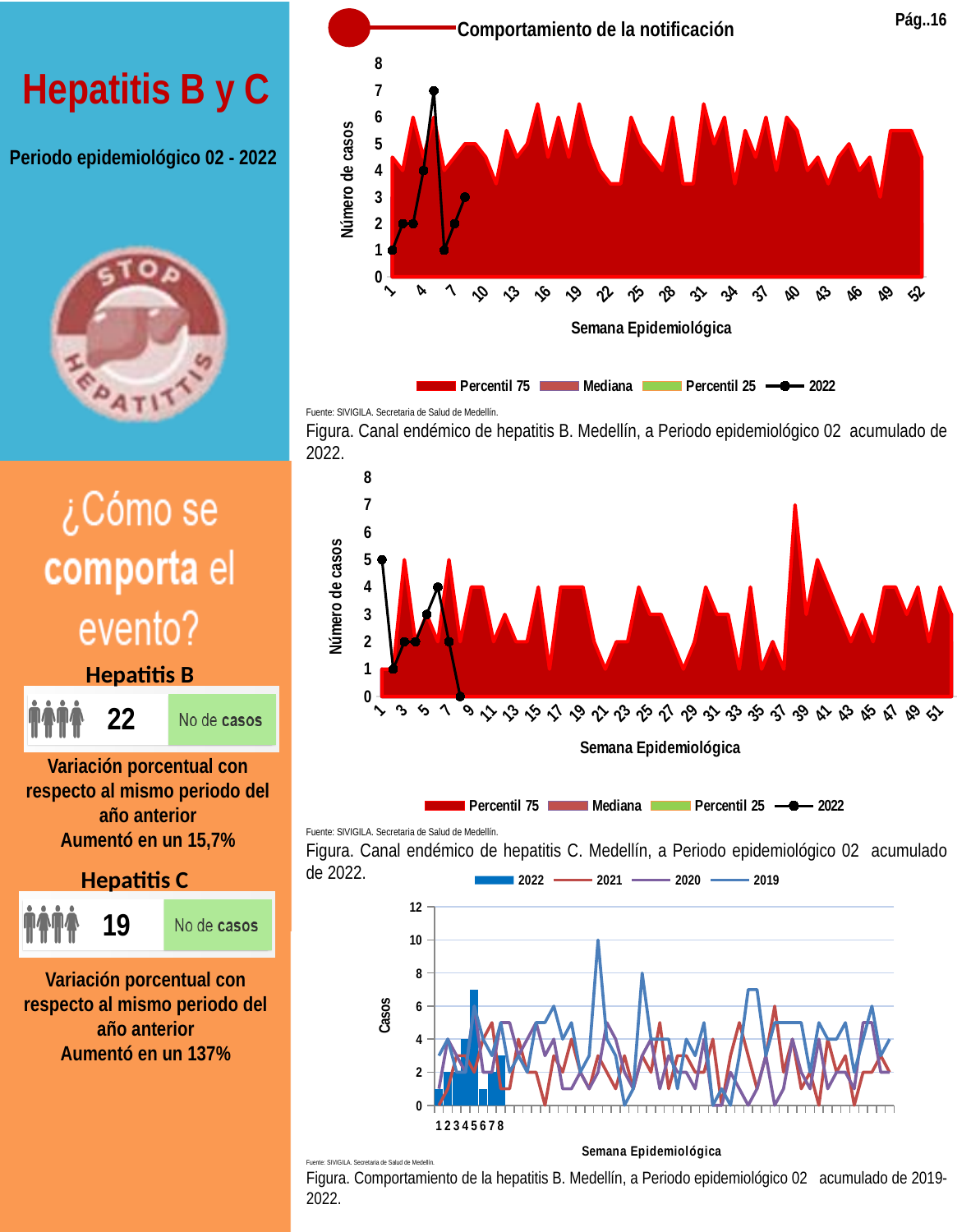
In the hepatitis B endemic channel chart (top), what is the number of cases for the 2022 line at week 1? 1 In the hepatitis C endemic channel chart (middle), which is larger for the 2022 line: the value at week 1 or at week 6? Week 1 In the bottom chart (Comportamiento de la hepatitis B 2019-2022), is the 2022 value at week 5 greater or less than 6? greater In the hepatitis B endemic channel chart (top), what is the title of the x axis? Semana Epidemiológica In the hepatitis B endemic channel chart (top), at which week does the 2022 line reach its highest value? Week 5 In the hepatitis C endemic channel chart (middle), at which week does the 2022 line reach its lowest value? Week 8 In the bottom chart (Comportamiento de la hepatitis B 2019-2022), which years are listed in the legend? 2022, 2021, 2020, 2019 In the hepatitis C endemic channel chart (middle), what is the number of cases for the 2022 line at week 1? 5 In the hepatitis B endemic channel chart (top), how many series does the legend list? 4 In the hepatitis B endemic channel chart (top), what is the number of cases for the 2022 line at week 5? 7 In the hepatitis C endemic channel chart (middle), how many series does the legend list? 4 In the hepatitis B endemic channel chart (top), what is the difference between the 2022 values at week 5 and week 1? 6